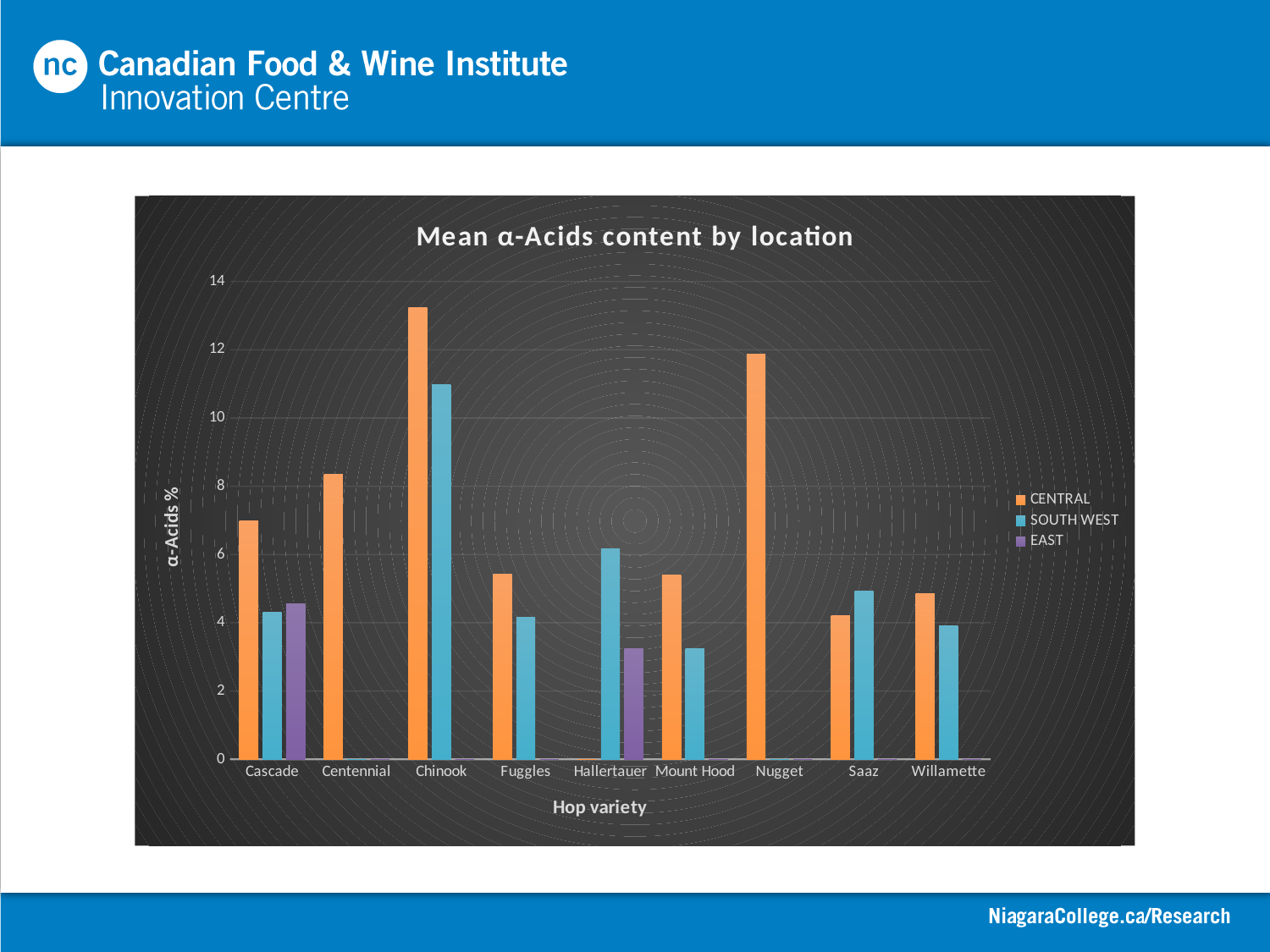
What is the title of the chart? Mean α-Acids content by location How many series does the legend list? 3 Which hop variety has the highest SOUTH WEST value? Chinook How many hop varieties are shown on the x axis? 9 Which hop variety has the highest CENTRAL value? Chinook For Saaz, which is larger: the CENTRAL value or the SOUTH WEST value? SOUTH WEST For Chinook, which is larger: the CENTRAL value or the SOUTH WEST value? CENTRAL Is the CENTRAL value for Cascade greater or less than 6? greater Is the SOUTH WEST value for Mount Hood greater or less than 4? less Is the CENTRAL value for Chinook greater or less than 12? greater What kind of chart is shown on the slide? bar chart